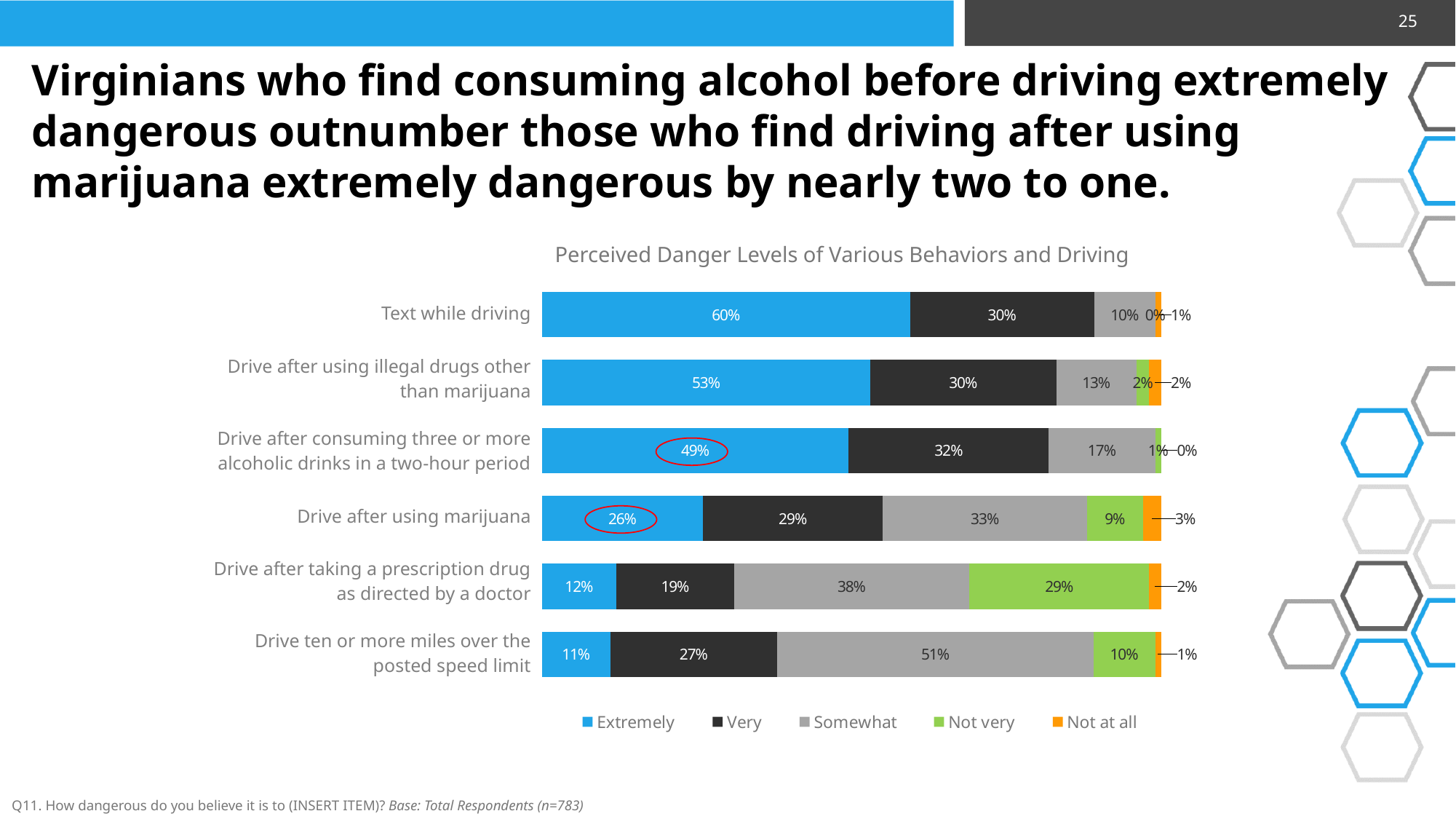
How many behaviors are shown in the chart? 6 Which behavior has the highest "Extremely" percentage? Text while driving What is the "Very" value for "Drive after consuming three or more alcoholic drinks in a two-hour period"? 32% What percentage of respondents rated texting while driving as "Extremely" dangerous? 60% Which behavior has the lowest "Extremely" percentage? Drive ten or more miles over the posted speed limit What is the title of the chart? Perceived Danger Levels of Various Behaviors and Driving What kind of chart is shown on the slide? Stacked bar chart What is the difference between the "Extremely" values for driving after three or more alcoholic drinks and driving after using marijuana? 23 percentage points How many series does the legend list? 5 What is the "Not very" value for "Drive after taking a prescription drug as directed by a doctor"? 29% Which has a larger "Somewhat" value: "Drive after using marijuana" or "Drive after taking a prescription drug as directed by a doctor"? Drive after taking a prescription drug as directed by a doctor What is the "Somewhat" value for "Drive ten or more miles over the posted speed limit"? 51%